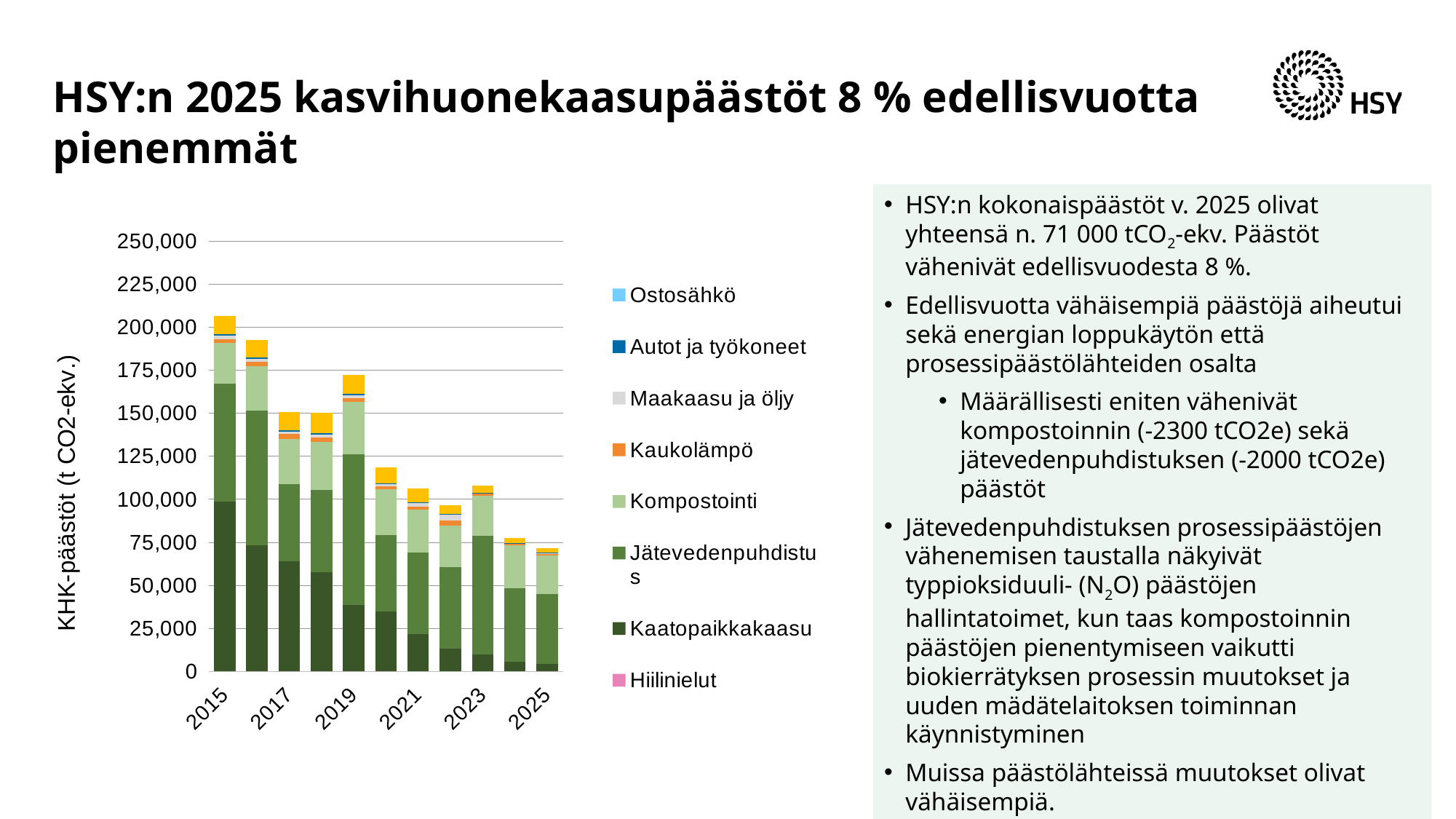
Which year has the highest total emissions in the chart? 2015 What is the label of the vertical axis of the chart? KHK-päästöt (t CO2-ekv.) Do total emissions generally rise or fall from 2015 to 2025? Fall What kind of chart is shown on the slide? Stacked bar chart Is the Kaatopaikkakaasu value for 2025 greater or less than 25,000? less How many series does the chart legend list? 8 Is the total emissions value for 2025 greater or less than 75,000? less Which year has the lowest total emissions in the chart? 2025 Is the total emissions value for 2015 greater or less than 200,000? greater How many years (bars) are plotted in the chart? 11 Which year has higher total emissions, 2017 or 2019? 2019